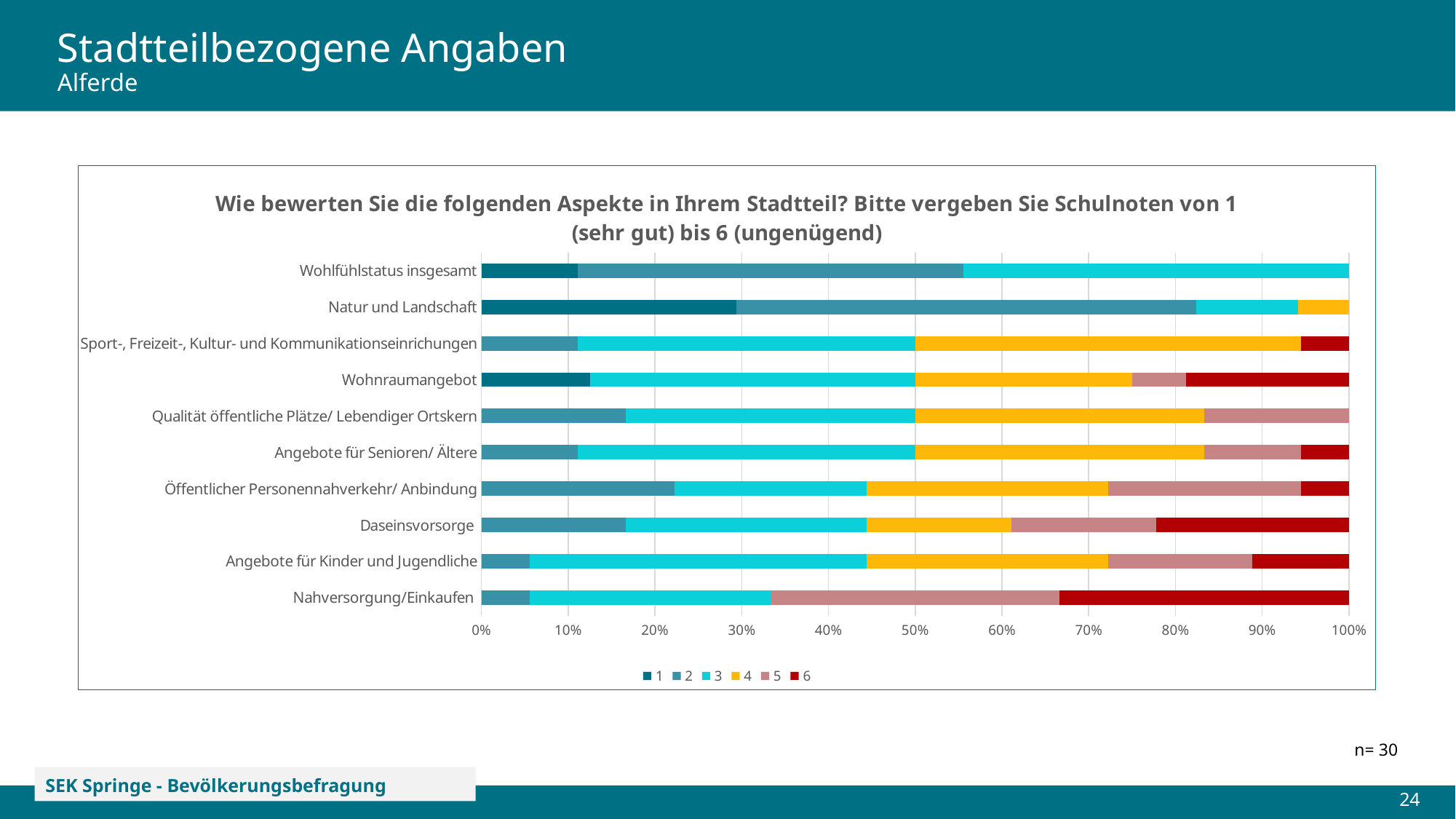
What are the legend entries of the chart? 1, 2, 3, 4, 5, 6 Is the share of grade 1 for Wohnraumangebot greater or less than 20%? less Is the share of grade 1 for Natur und Landschaft greater or less than 20%? greater What kind of chart is shown on the slide? stacked bar chart Which has a larger share of grade 1: Natur und Landschaft or Wohlfühlstatus insgesamt? Natur und Landschaft Is the share of grade 6 for Nahversorgung/Einkaufen greater or less than 20%? greater How many categories (aspects) are plotted on the chart? 10 Which category has the largest share of grade 1 (dark teal)? Natur und Landschaft How many series does the legend list? 6 Which category has the largest share of grade 6 (dark red)? Nahversorgung/Einkaufen What is the total of the stacked bar for Wohnraumangebot? 100%